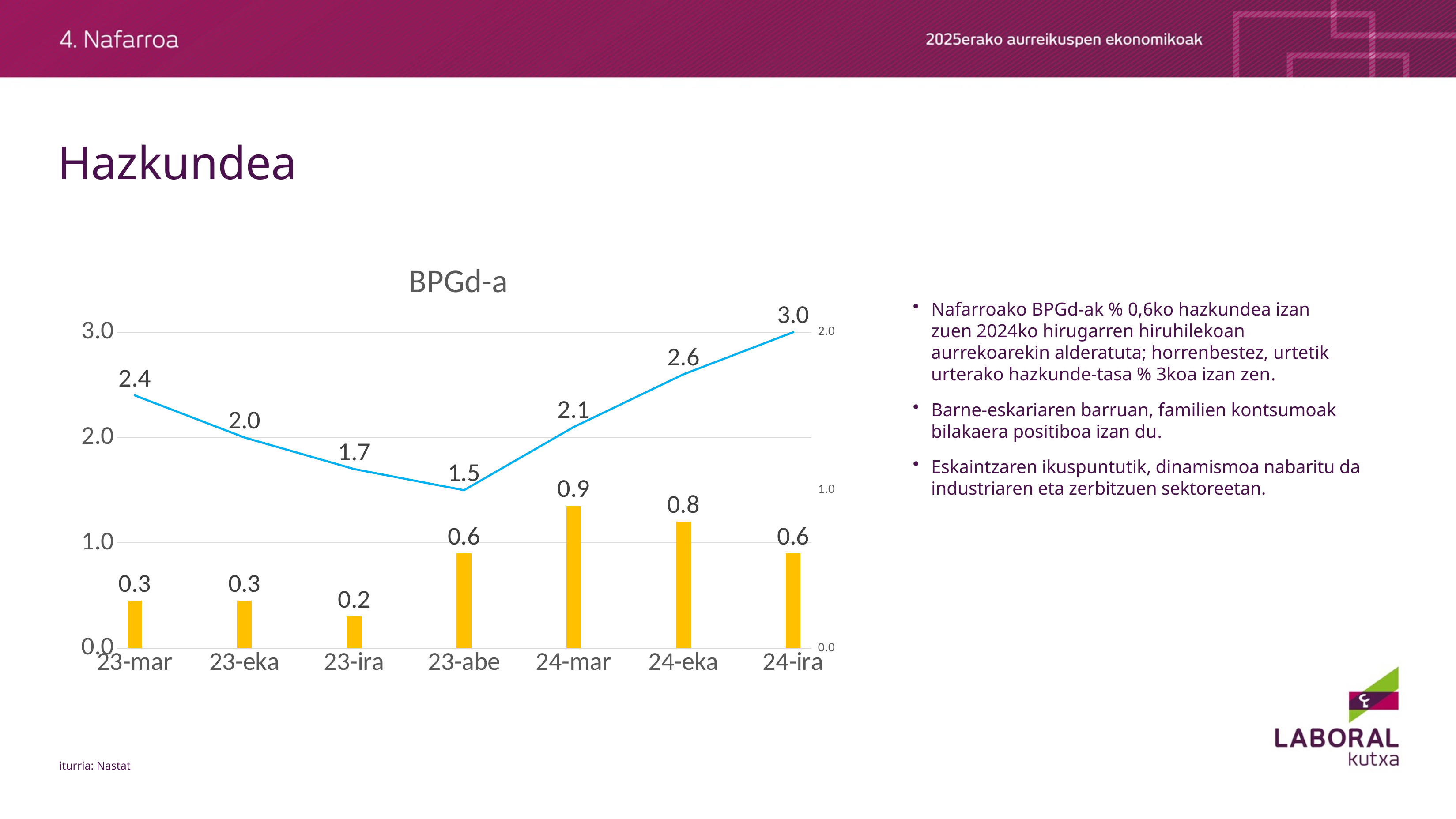
What is the title of the chart? BPGd-a Which category has the lowest bar value? 23-ira How many categories are shown on the x axis? 7 What is the value of the line at 24-ira? 3.0 What is the value of the bar for 23-ira? 0.2 What is the value of the line at 23-abe? 1.5 Does the line rise or fall from 23-abe to 24-ira? rise Which is larger, the bar value for 24-eka or the bar value for 24-ira? 24-eka Which category has the highest bar value? 24-mar At which category does the line reach its lowest value? 23-abe What is the difference between the line values at 24-ira and 23-abe? 1.5 What is the value of the bar for 24-mar? 0.9